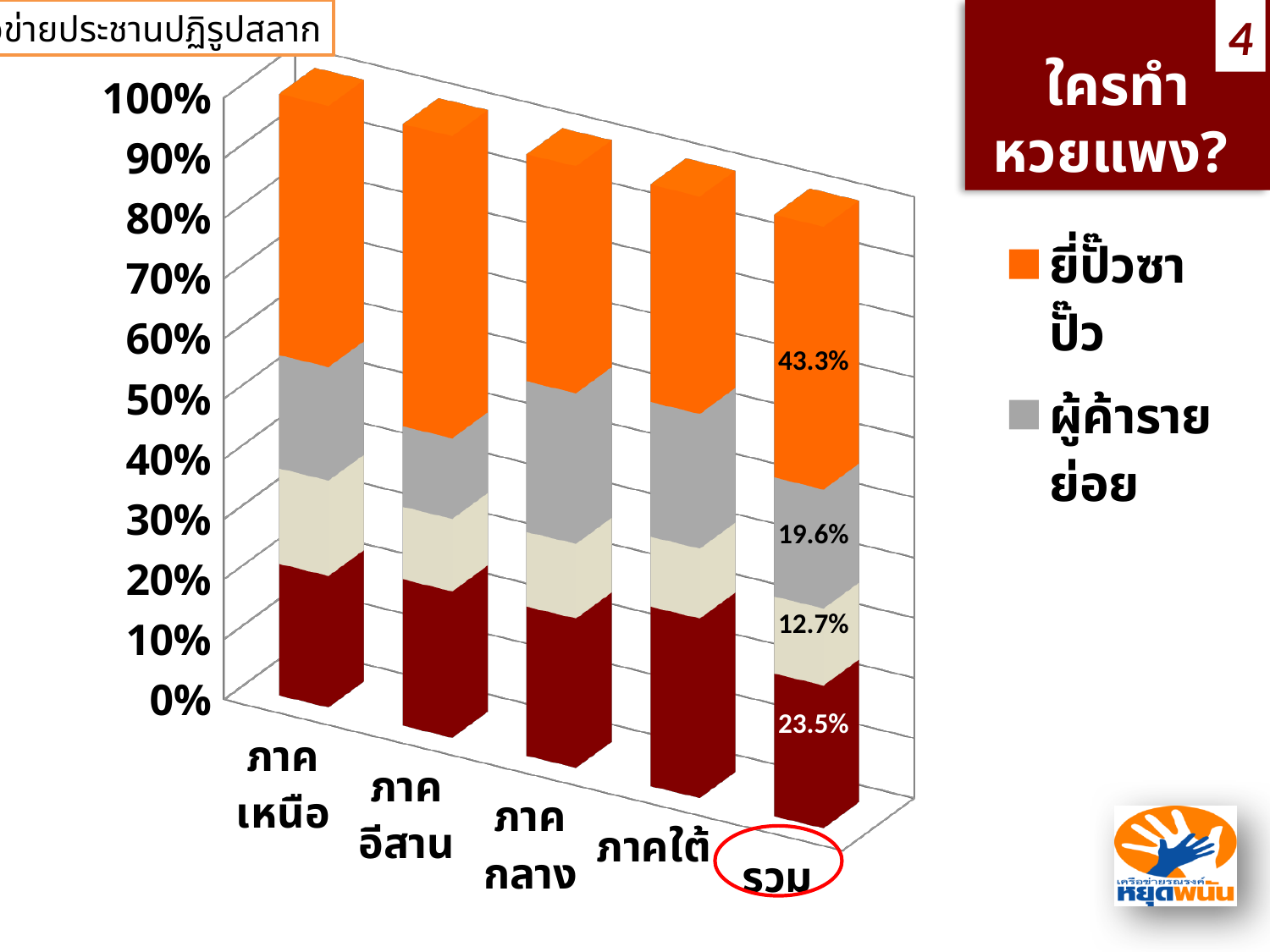
What kind of chart is shown on the slide? stacked bar chart How many categories are shown along the x axis of the chart? 5 What value is labelled on the cream-coloured segment of the รวม bar? 12.7% In the รวม bar, what is the difference between ยี่ปั๊วซาปั๊ว and ผู้ค้ารายย่อย? 23.7 percentage points What is the value of ผู้ค้ารายย่อย for รวม? 19.6% What value is labelled on the dark red bottom segment of the รวม bar? 23.5% What is the total of the four labelled segments in the รวม bar? 99.1% In the รวม bar, which is larger: ยี่ปั๊วซาปั๊ว or ผู้ค้ารายย่อย? ยี่ปั๊วซาปั๊ว How many series does the chart's legend list? 2 Which labelled segment of the รวม bar has the highest value? ยี่ปั๊วซาปั๊ว (43.3%) Which category label on the x axis is circled in red? รวม What is the value of ยี่ปั๊วซาปั๊ว for รวม? 43.3%